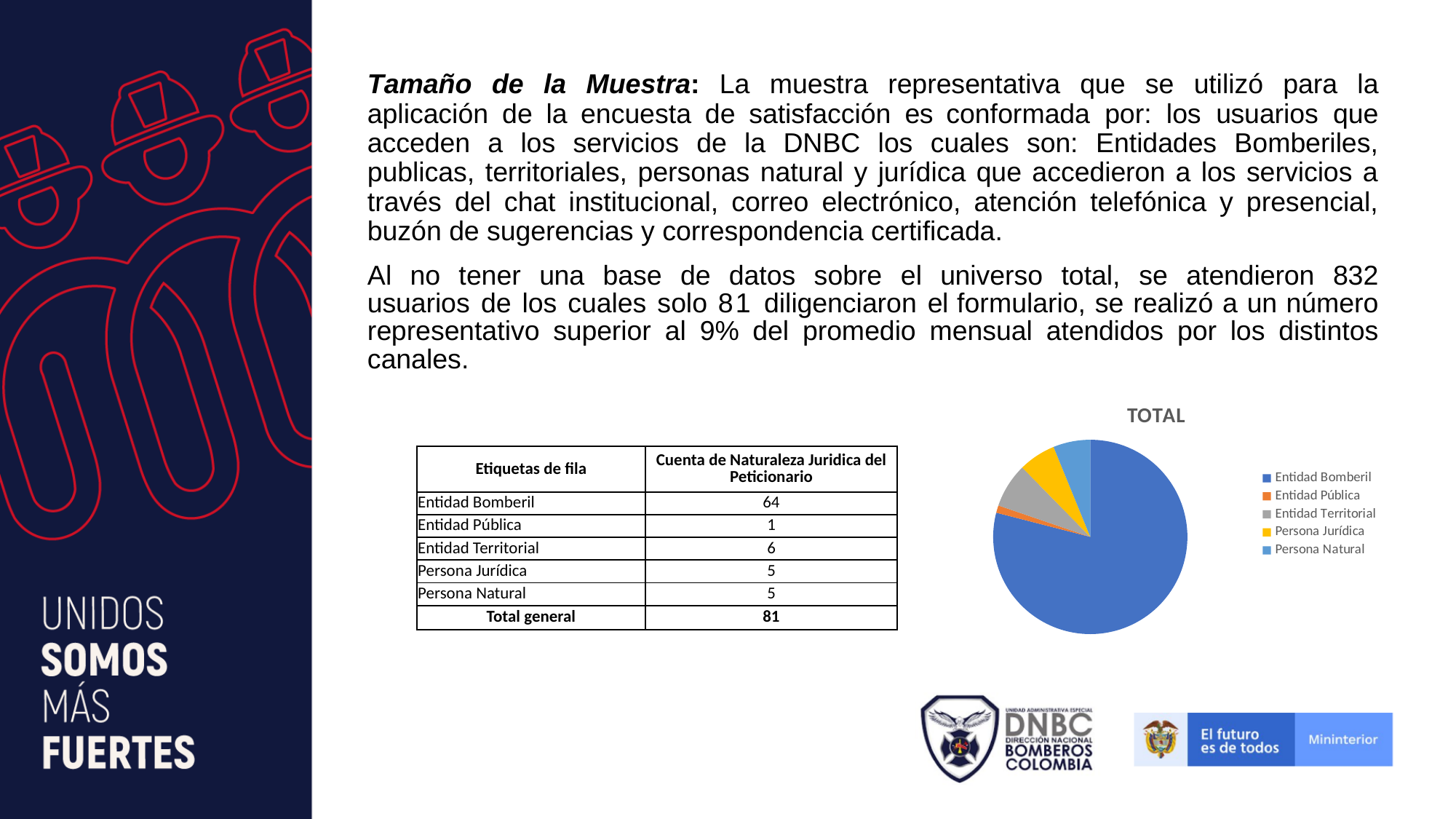
How many categories does the pie chart's legend list? 5 According to the table, what is the count for Entidad Territorial? 6 Which category has the smallest slice in the pie chart? Entidad Pública What kind of chart is shown on the slide? pie chart What is the difference between the counts for Entidad Bomberil and Entidad Territorial in the table? 58 What is the title of the pie chart? TOTAL Which category has the largest slice in the pie chart? Entidad Bomberil According to the table, what is the count for Entidad Bomberil? 64 What is the Total general shown in the table? 81 What colour is the Entidad Bomberil slice in the pie chart? blue According to the table, what is the count for Persona Jurídica? 5 Which slice is larger in the pie chart, Entidad Territorial or Entidad Pública? Entidad Territorial